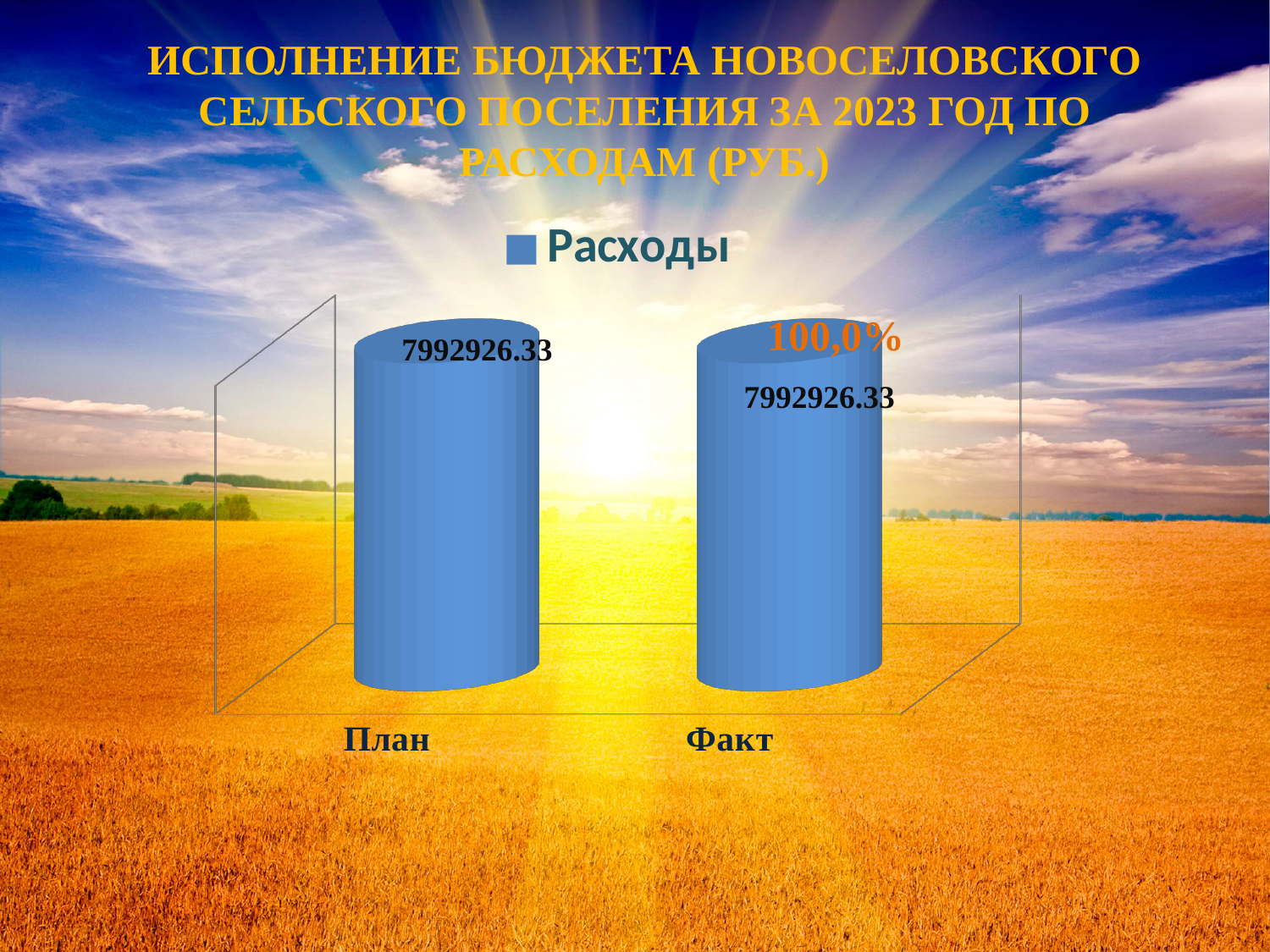
What is the value for Факт? 7992926.33 What series name is shown in the legend? Расходы What percentage is printed above the Факт bar? 100,0% What are the two category labels on the x axis? План, Факт How many categories are shown on the x axis? 2 What kind of chart is shown on the slide? bar chart What is the difference between the values for План and Факт? 0 How many series does the legend list? 1 What is the value for План? 7992926.33